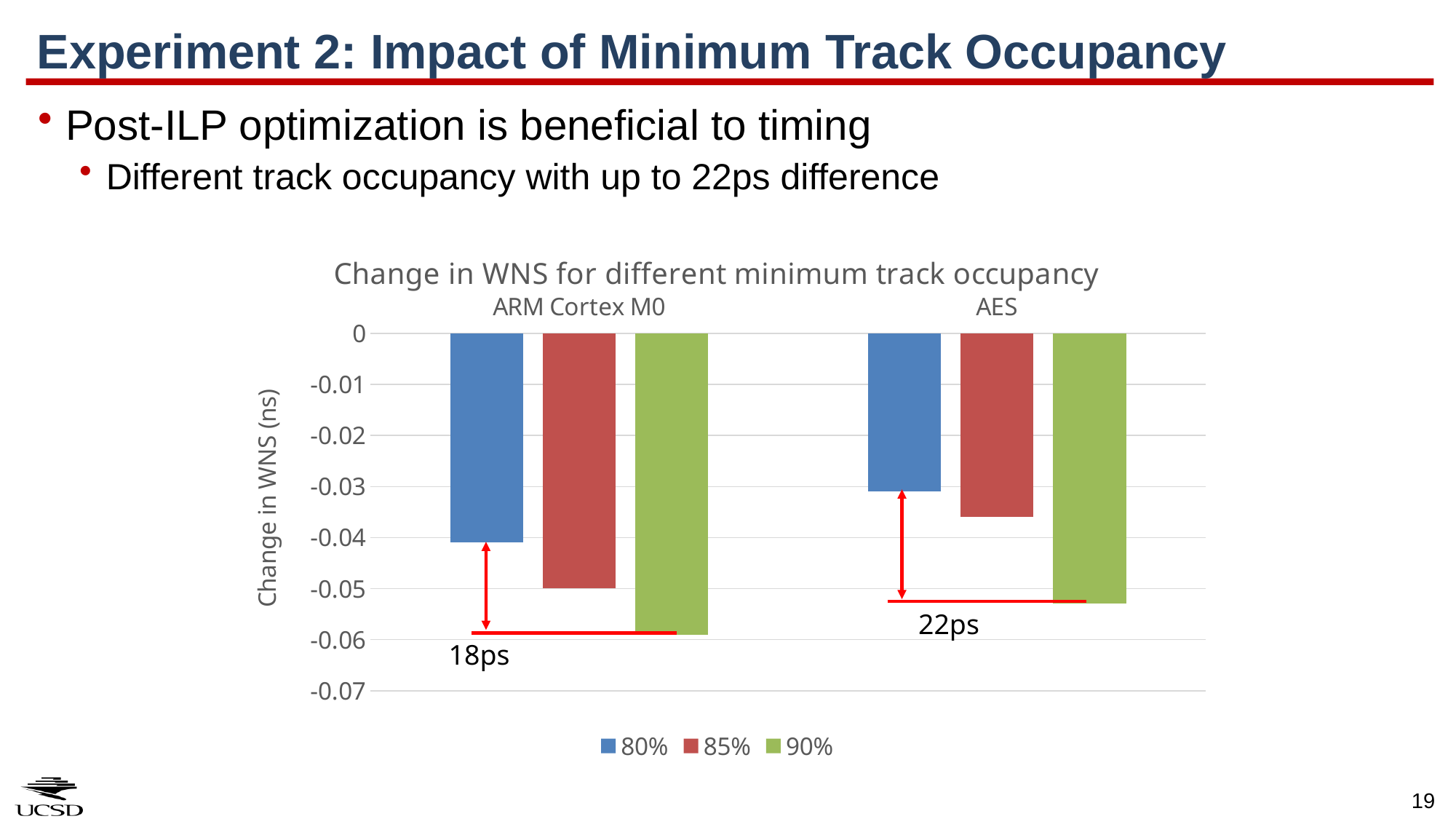
What difference is annotated between the 80% and 90% bars for AES? 22ps What is the y-axis label of the chart? Change in WNS (ns) Which has the more negative change in WNS for the 90% series: ARM Cortex M0 or AES? ARM Cortex M0 What difference is annotated between the 80% and 90% bars for ARM Cortex M0? 18ps How many design categories are shown on the x axis of the chart? 2 For AES, which track occupancy series has the change in WNS closest to zero? 80% Is the value for 85% in AES greater or less than -0.04? greater What kind of chart is shown on the slide? bar chart Is the value for 80% in ARM Cortex M0 greater or less than -0.03? less How many series does the chart legend list? 3 For ARM Cortex M0, which track occupancy series has the most negative change in WNS? 90% What is the title of the chart? Change in WNS for different minimum track occupancy